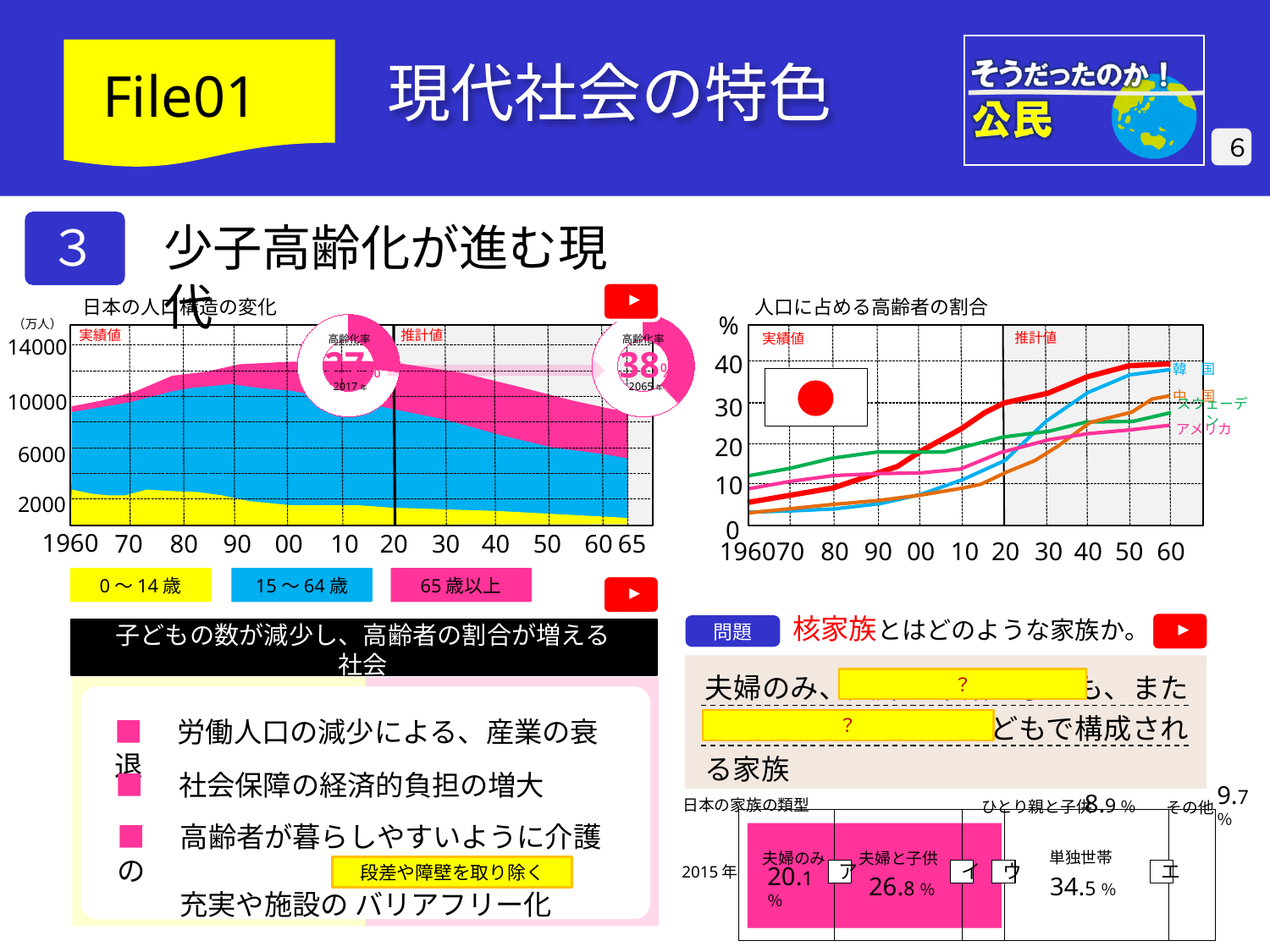
In the chart titled 日本の家族の類型, what is the value for 単独世帯? 34.5% In the chart titled 日本の家族の類型, what is the value for 夫婦と子供? 26.8% In the chart titled 人口に占める高齢者の割合, is the value for Japan (red line) in 2060 greater or less than 30? greater What kind of chart is 人口に占める高齢者の割合? line chart In the chart titled 日本の家族の類型, which is larger, 夫婦のみ or 夫婦と子供? 夫婦と子供 In the chart titled 人口に占める高齢者の割合, is the value for 韓国 in 1960 greater or less than 10? less In the chart titled 日本の家族の類型, how many family types are shown? 5 In the chart titled 日本の家族の類型, what is the difference between 単独世帯 and 夫婦と子供? 7.7% In the chart titled 日本の家族の類型, which family type has the smallest share? ひとり親と子供 In the chart titled 日本の人口構造の変化, how many age groups does the legend list? 3 In the chart titled 日本の家族の類型, which family type has the largest share? 単独世帯 In the chart titled 日本の人口構造の変化, what is the 高齢化率 shown for 2065年? 38%